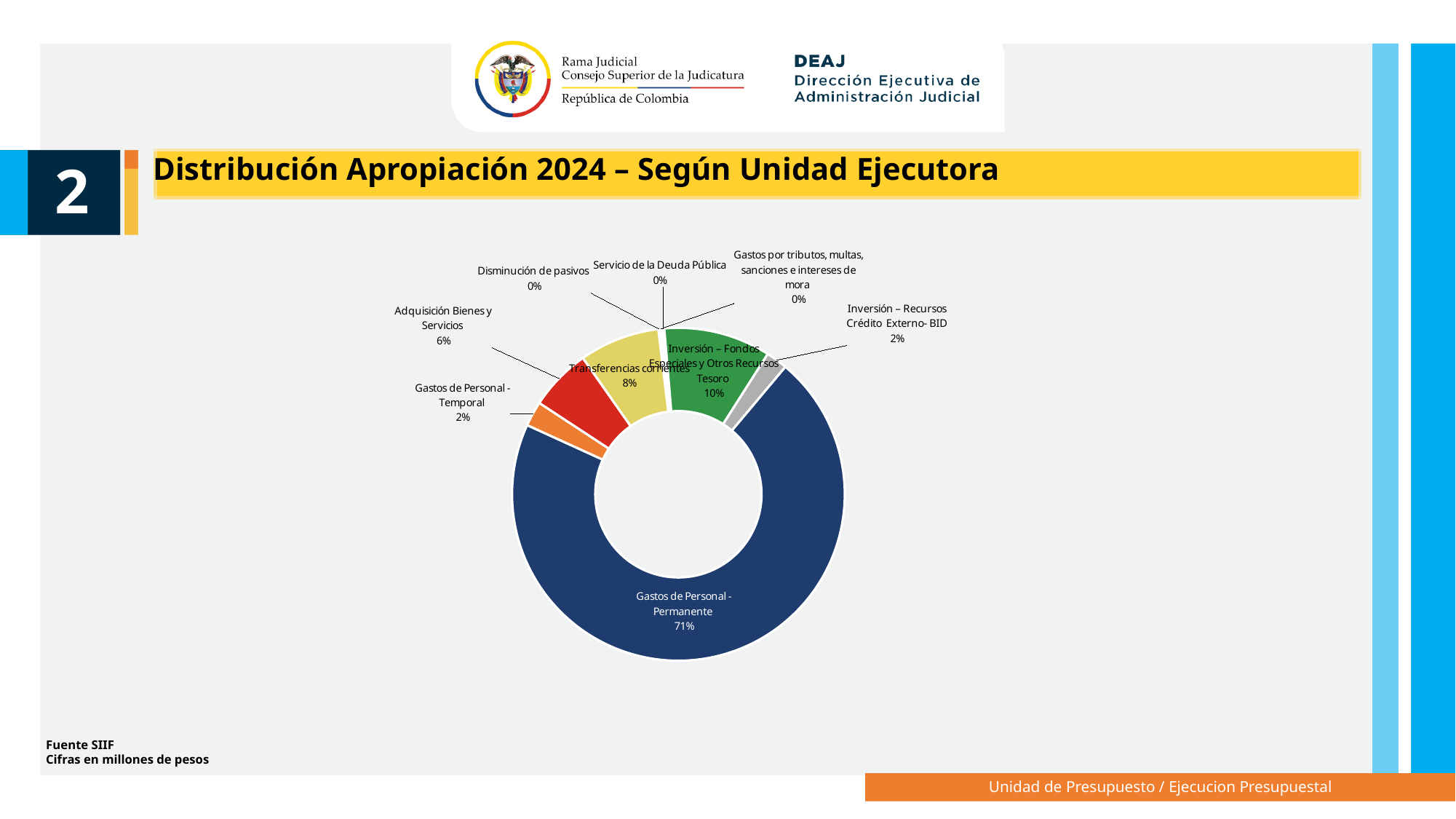
How many categories are labelled with 0%? 3 What percentage is shown for Inversión – Recursos Crédito Externo- BID? 2% What share of the chart does Gastos de Personal - Permanente represent? 71% Which category has the largest share of the chart? Gastos de Personal - Permanente What kind of chart is shown on the slide? Pie chart (doughnut) What percentage is shown for Adquisición Bienes y Servicios? 6% What percentage is shown for Inversión – Fondos Especiales y Otros Recursos Tesoro? 10% How many categories are shown in the chart? 9 What is the difference in percentage points between Gastos de Personal - Permanente and Inversión – Fondos Especiales y Otros Recursos Tesoro? 61 percentage points Which is larger, the share for Transferencias corrientes or the share for Adquisición Bienes y Servicios? Transferencias corrientes What is the title of the slide containing the chart? Distribución Apropiación 2024 – Según Unidad Ejecutora What percentage is shown for Transferencias corrientes? 8%